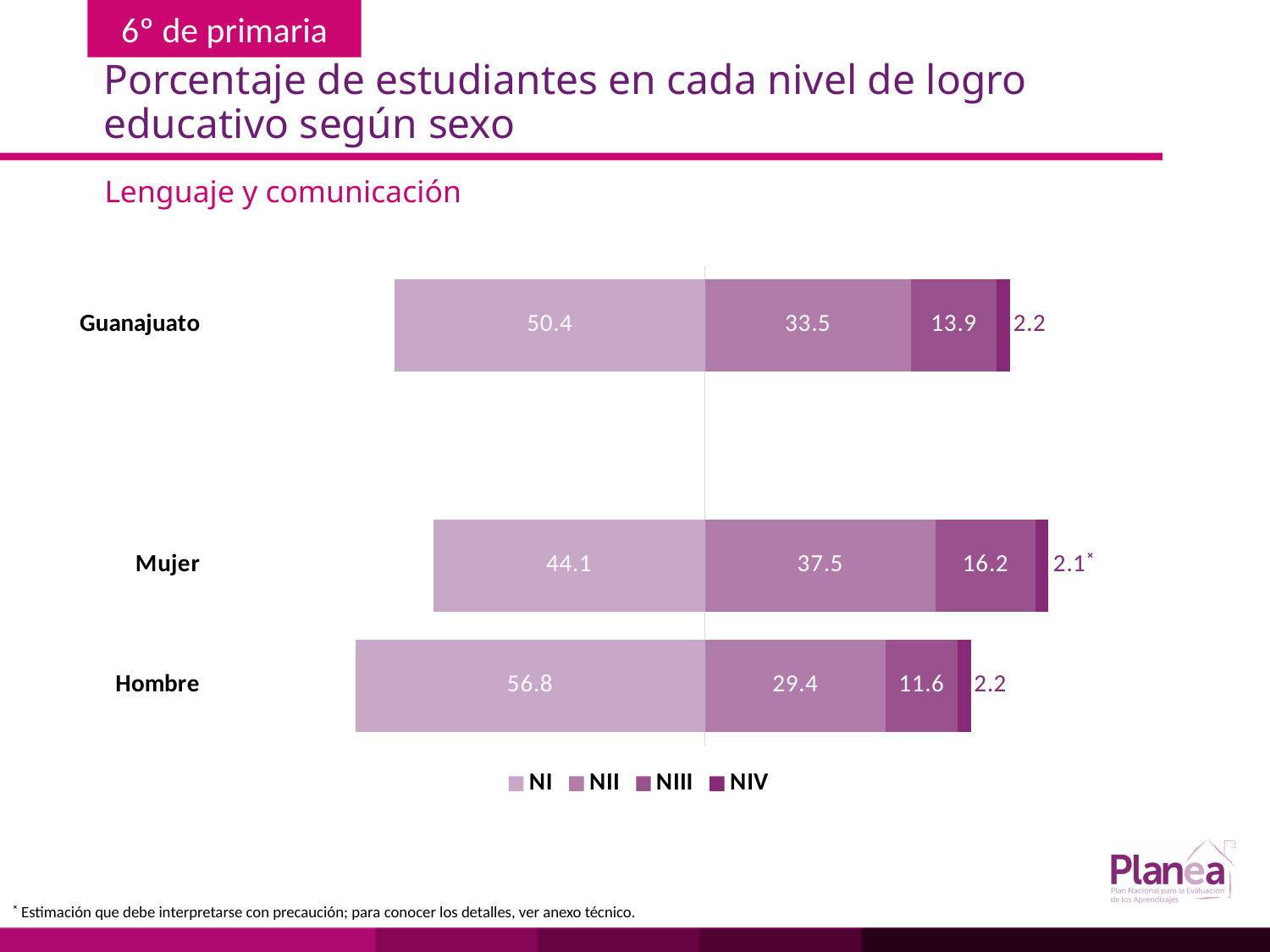
How many categories (bars) are shown in the chart? 3 What is the NII value for Mujer? 37.5 What is the subtitle shown above the chart? Lenguaje y comunicación Which is larger, the NII value for Guanajuato or the NII value for Hombre? Guanajuato Which category has the lowest NIII value? Hombre How many series does the legend list? 4 Which category has the highest NI value? Hombre What is the NIV value for Mujer? 2.1 What is the NI value for Guanajuato? 50.4 What is the NIII value for Hombre? 11.6 What is the difference between the NI values for Hombre and Mujer? 12.7 What kind of chart is shown on the slide? Stacked bar chart